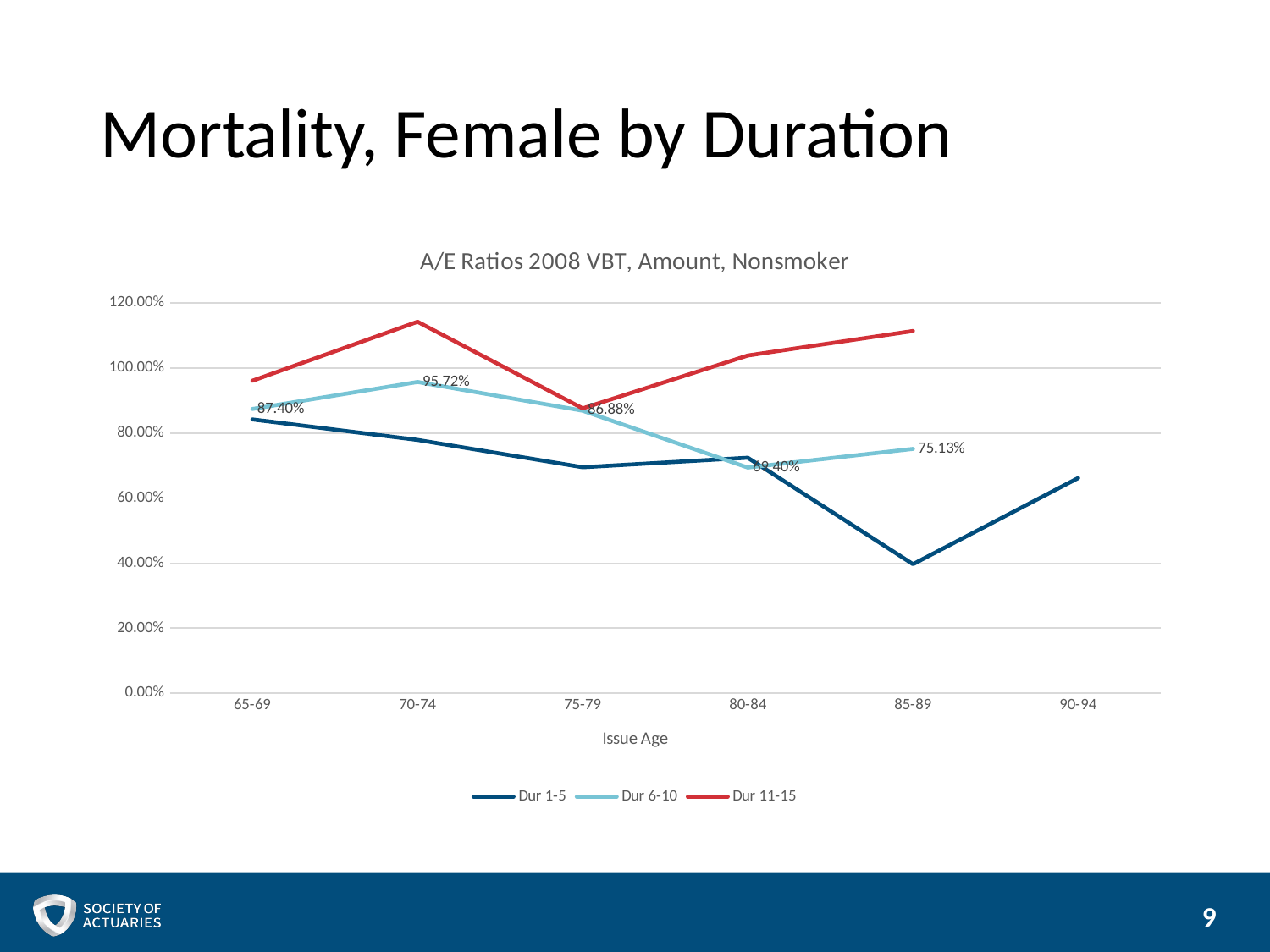
How many series does the legend list? 3 At issue age 65-69, which series has the larger value, Dur 11-15 or Dur 1-5? Dur 11-15 At which issue age is the Dur 6-10 series lowest? 80-84 What is the value for Dur 6-10 at issue age 65-69? 87.40% What is the value for Dur 6-10 at issue age 85-89? 75.13% What is the difference between the Dur 6-10 values at issue ages 70-74 and 80-84? 26.32% What is the title of the x axis? Issue Age What kind of chart is shown on the slide? line chart How many issue age categories are shown on the x axis? 6 At which issue age is the Dur 6-10 series highest? 70-74 Is the value for Dur 1-5 at issue age 85-89 greater or less than 60.00%? less What is the value for Dur 6-10 at issue age 70-74? 95.72%